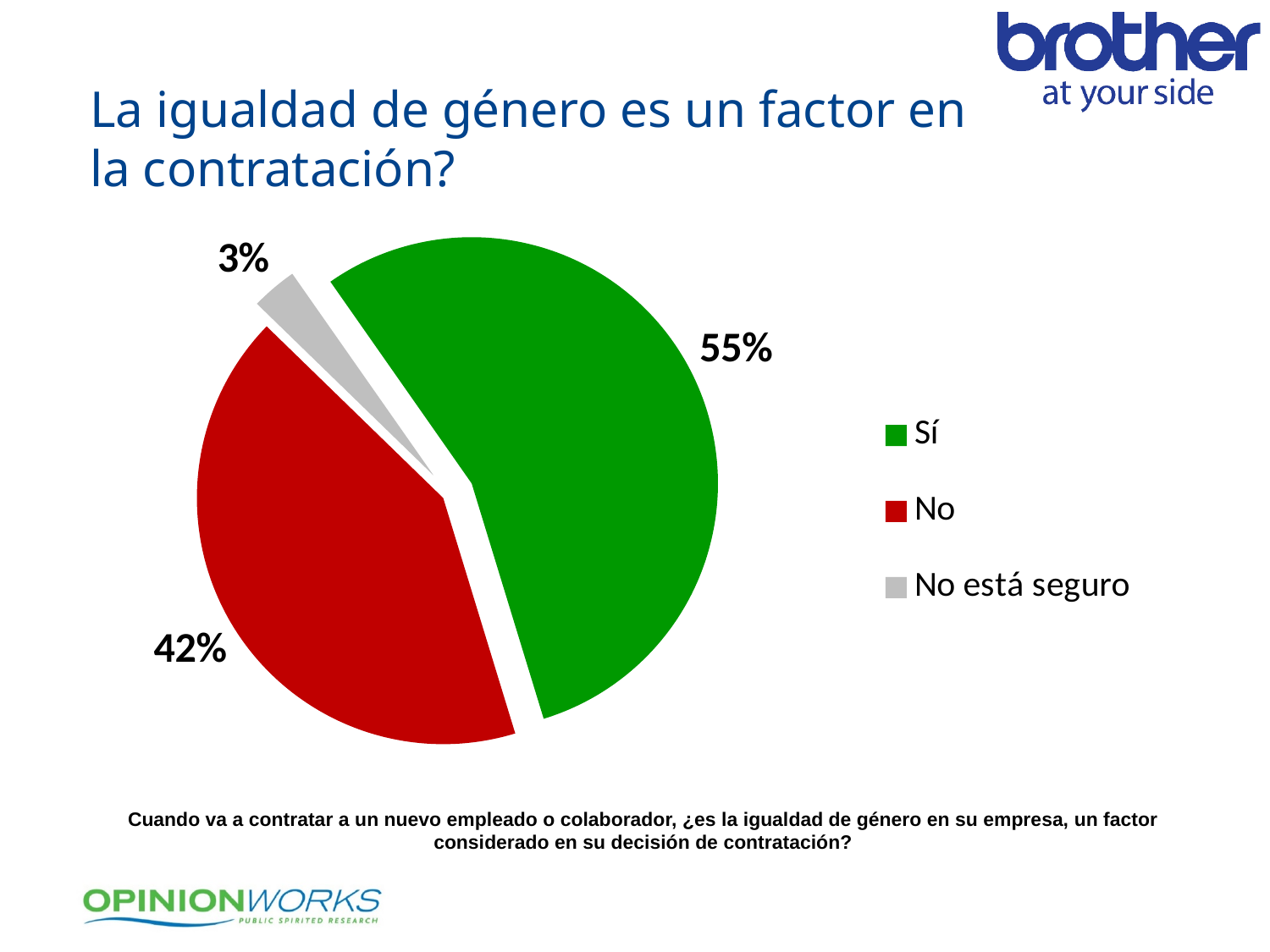
What kind of chart is shown on the slide? Pie chart What share of the pie does the "Sí" slice represent? 55% Which response has the smallest share of the pie? No está seguro What percentage of respondents answered "Sí"? 55% What colour is the "No" slice in the pie chart? Red How many slices does the pie chart have? 3 What percentage of respondents answered "No está seguro"? 3% What is the difference in percentage points between "Sí" and "No"? 13 What percentage of respondents answered "No"? 42% Which is larger, the share for "No" or the share for "No está seguro"? No Which response has the largest share of the pie? Sí How many entries does the legend list? 3